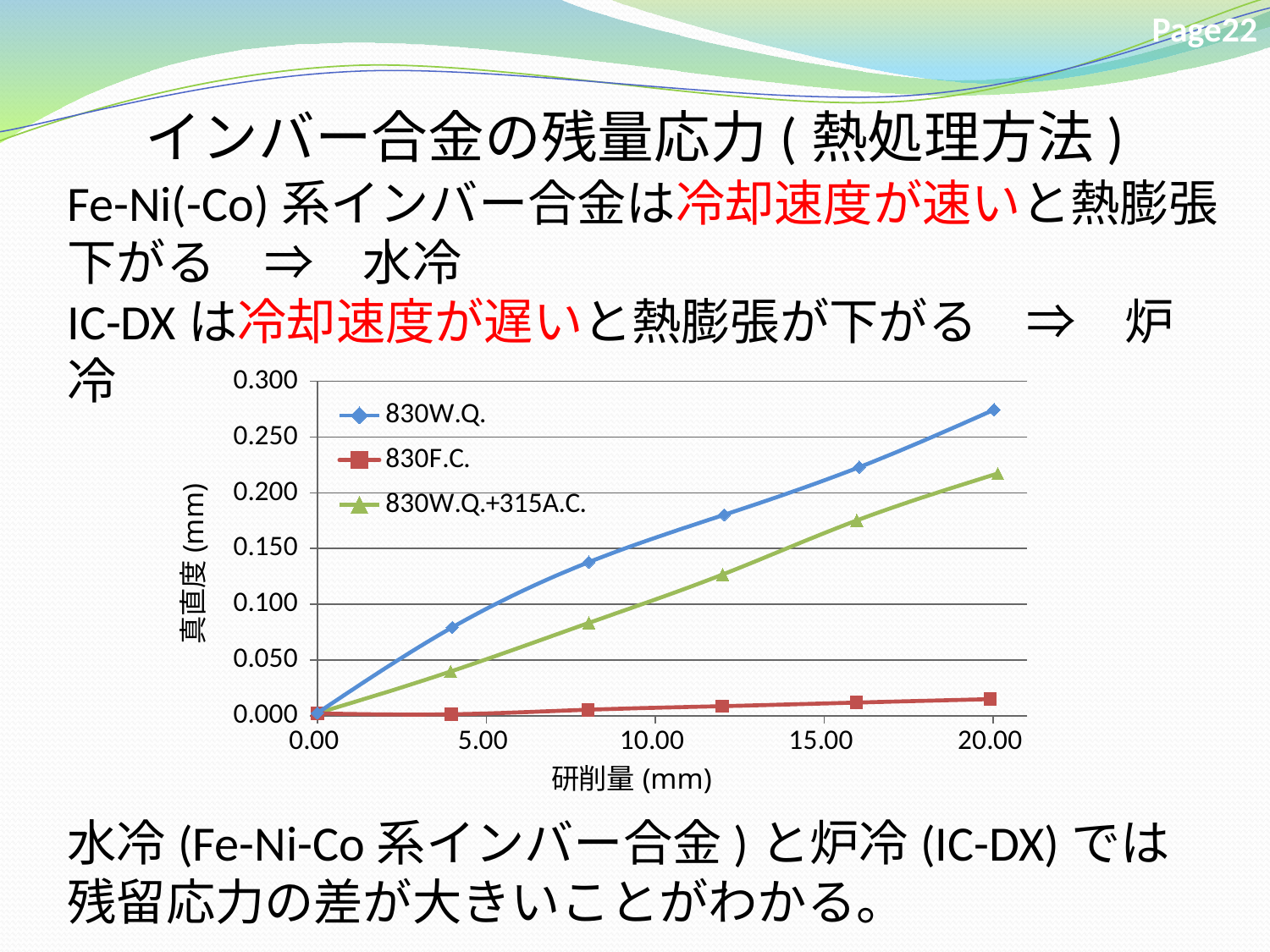
Do the values for 830W.Q. rise or fall as 研削量 increases? rise Is the value for 830W.Q. at 研削量 20.00 mm greater or less than 0.250? greater How many series does the chart legend list? 3 What is the label of the x axis? 研削量 (mm) Is the value for 830F.C. at 研削量 20.00 mm greater or less than 0.050? less Is the value for 830W.Q. at 研削量 8.00 mm greater or less than 0.100? greater How many data points are plotted for the 830W.Q. series? 6 What kind of chart is shown on the slide? line chart Which series has the lowest value at 研削量 20.00 mm? 830F.C. At 研削量 12.00 mm, which series has the larger value, 830W.Q. or 830W.Q.+315A.C.? 830W.Q. Which series has the highest value at 研削量 20.00 mm? 830W.Q.